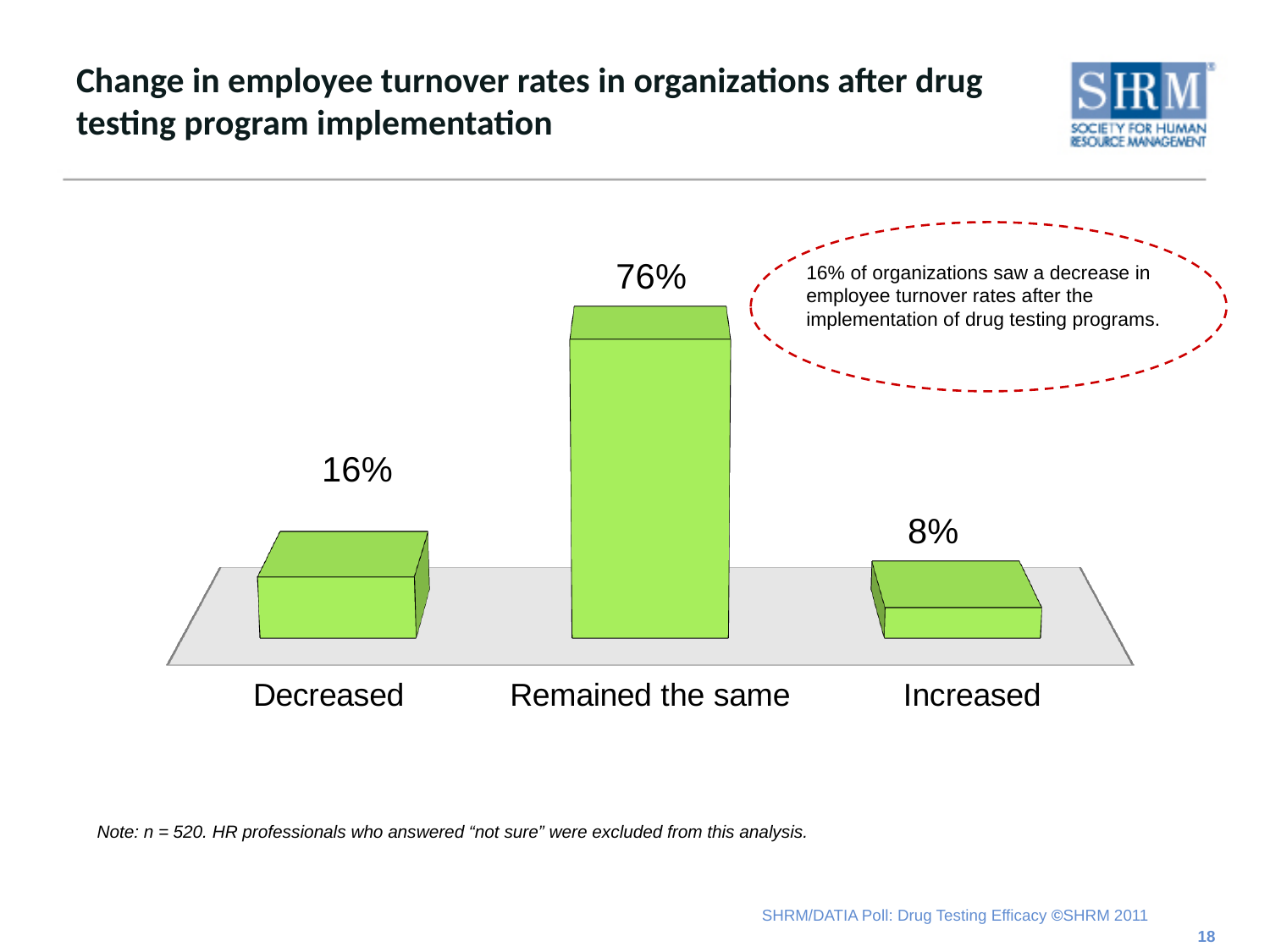
Which is larger, the value for 'Decreased' or the value for 'Increased'? Decreased What percentage of organizations reported that turnover rates increased? 8% What is the difference between the 'Remained the same' and 'Decreased' values? 60% Which category has the highest value? Remained the same Which category has the lowest value? Increased What is the total of the three percentages shown in the chart? 100% What is the sample size (n) given in the note below the chart? 520 What is the value shown for 'Remained the same'? 76% What percentage of organizations reported that employee turnover rates decreased after drug testing program implementation? 16% How many categories are shown in the chart? 3 What is the difference between the 'Decreased' and 'Increased' values? 8% What kind of chart is shown on the slide? Bar chart